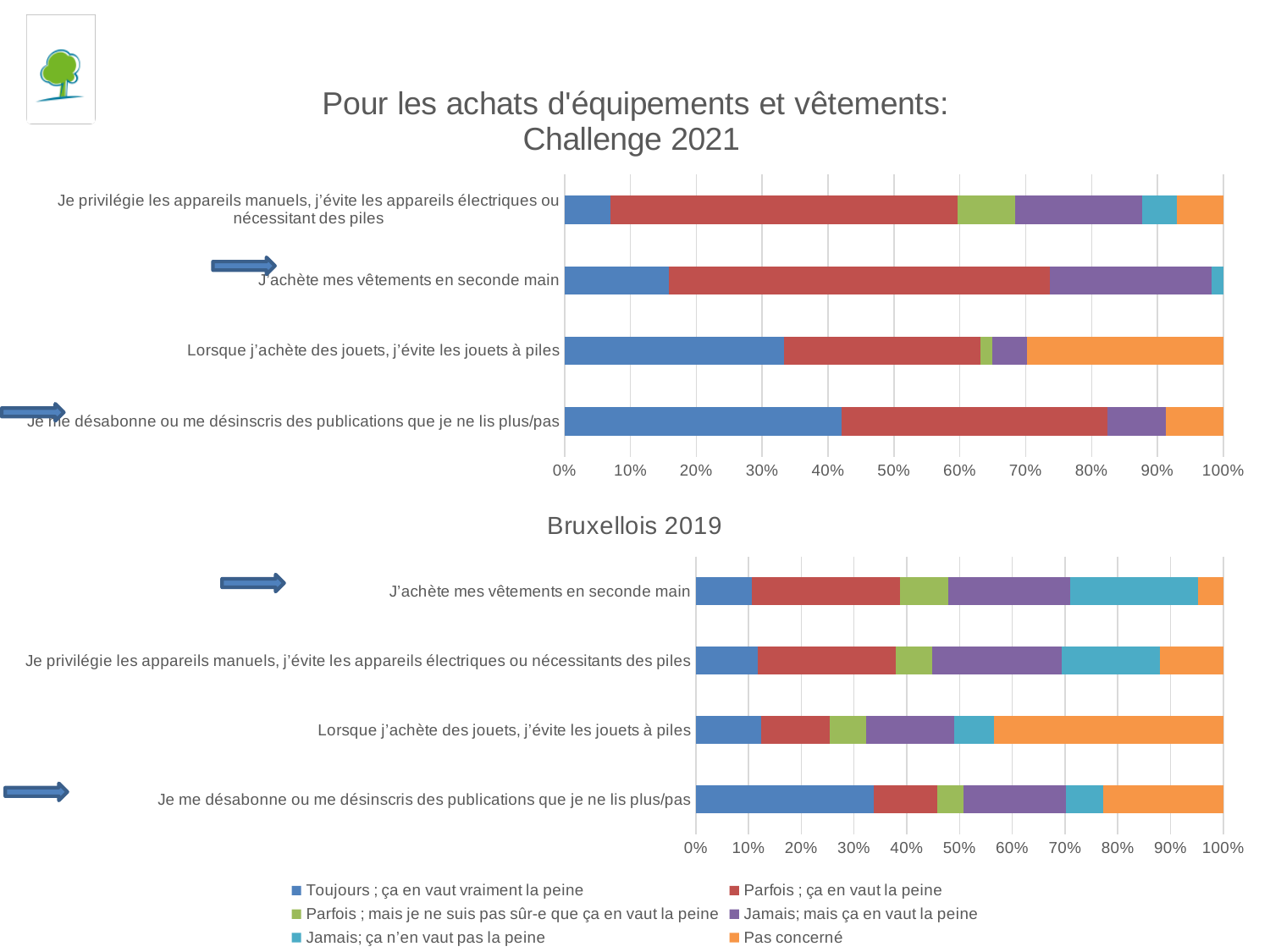
In the "Bruxellois 2019" chart, is the "Toujours ; ça en vaut vraiment la peine" value for "Lorsque j'achète des jouets, j'évite les jouets à piles" greater or less than 20%? less What kind of chart is the "Challenge 2021" chart? Stacked bar chart In the "Bruxellois 2019" chart, which category has the largest "Toujours ; ça en vaut vraiment la peine" segment? Je me désabonne ou me désinscris des publications que je ne lis plus/pas How many series does the legend list? 6 How many categories are shown in the "Bruxellois 2019" chart? 4 In the "Challenge 2021" chart, which has the larger "Toujours ; ça en vaut vraiment la peine" segment: "Je me désabonne ou me désinscris des publications que je ne lis plus/pas" or "J'achète mes vêtements en seconde main"? Je me désabonne ou me désinscris des publications que je ne lis plus/pas In the "Challenge 2021" chart, which category has the smallest "Toujours ; ça en vaut vraiment la peine" segment? Je privilégie les appareils manuels, j'évite les appareils électriques ou nécessitant des piles In the "Challenge 2021" chart, is the "Toujours ; ça en vaut vraiment la peine" value for "J'achète mes vêtements en seconde main" greater or less than 20%? less What colour represents the "Pas concerné" series in the legend? Orange How many categories are shown in the "Challenge 2021" chart? 4 In the "Challenge 2021" chart, which category has the largest "Toujours ; ça en vaut vraiment la peine" segment? Je me désabonne ou me désinscris des publications que je ne lis plus/pas In the "Challenge 2021" chart, is the "Toujours ; ça en vaut vraiment la peine" value for "Je me désabonne ou me désinscris des publications que je ne lis plus/pas" greater or less than 30%? greater